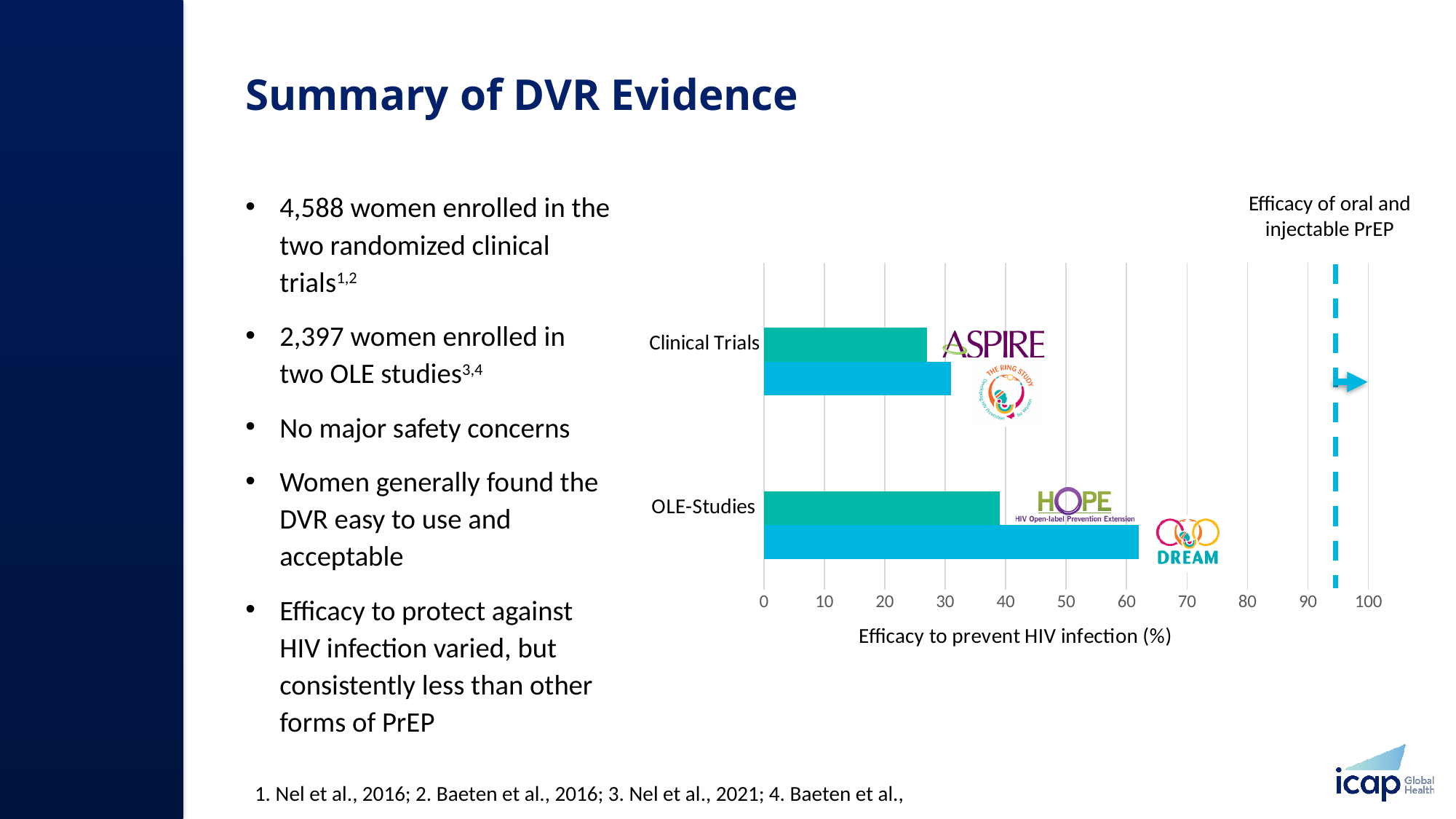
Is the value of the lower bar for Clinical Trials greater or less than 50? less What is the maximum value shown on the horizontal axis of the chart? 100 Is the value of the lower bar for OLE-Studies greater or less than 50? greater What is the title of the horizontal axis of the chart? Efficacy to prevent HIV infection (%) Is the dashed vertical line on the chart positioned greater or less than 90 on the horizontal axis? greater What does the dashed vertical line on the chart represent? Efficacy of oral and injectable PrEP What kind of chart is shown on the slide? bar chart Which is larger: the lower bar for OLE-Studies or the lower bar for Clinical Trials? OLE-Studies How many categories are shown on the vertical axis of the chart? 2 Which category has the longest bar in the chart? OLE-Studies